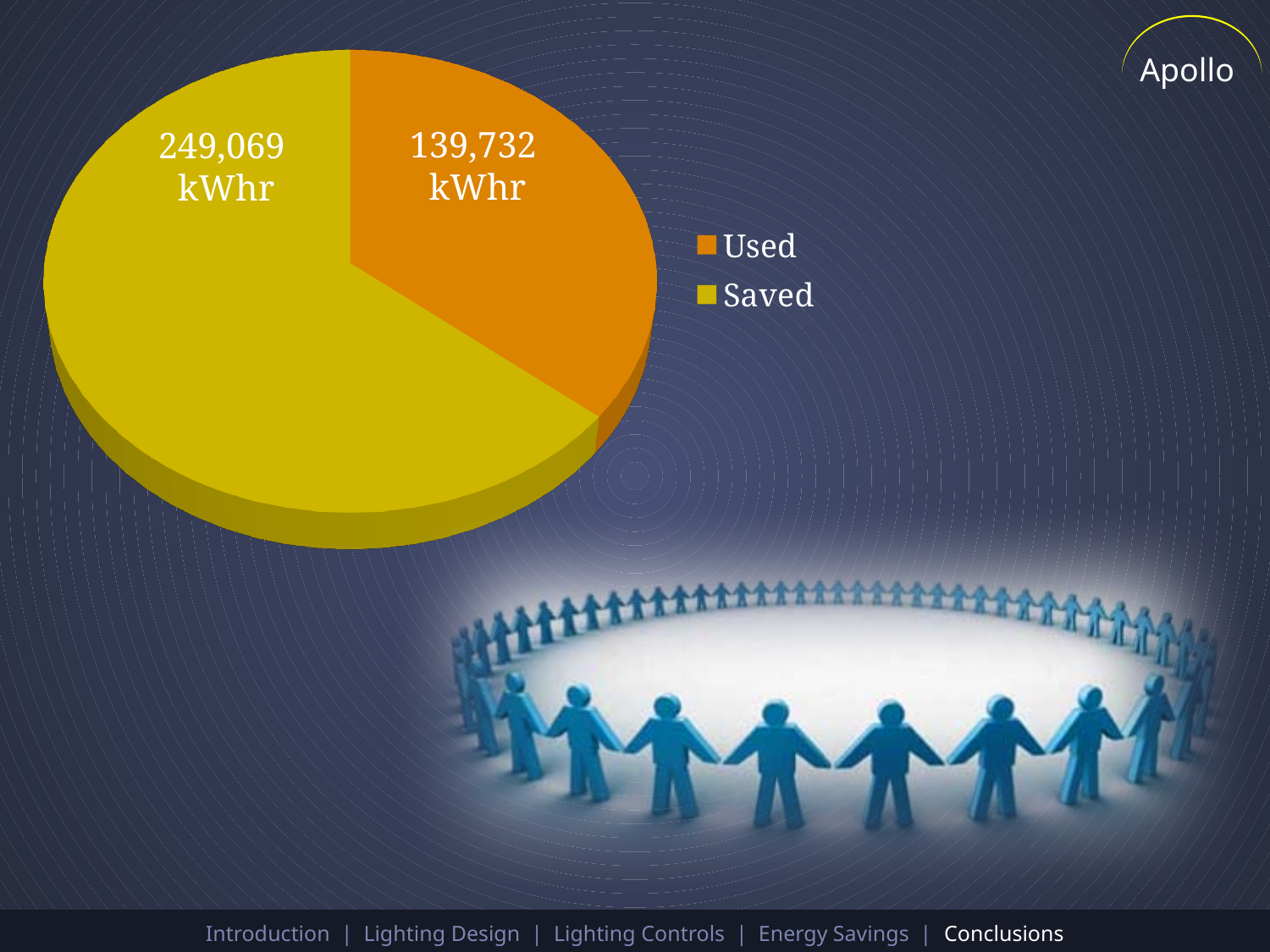
What kind of chart is shown on the slide? Pie chart What is the value of the Used slice in the pie chart? 139,732 kWhr Is the Saved value larger or smaller than the Used value? Larger Which slice of the pie chart is the smallest? Used How many entries does the legend of the pie chart list? 2 What colour is the Used slice in the pie chart? Orange What is the value of the Saved slice in the pie chart? 249,069 kWhr What are the two legend entries of the pie chart? Used and Saved What is the difference between the Saved and Used values in the pie chart? 109,337 kWhr How many slices does the pie chart have? 2 What is the total of the two slices in the pie chart? 388,801 kWhr Which slice of the pie chart is the largest? Saved